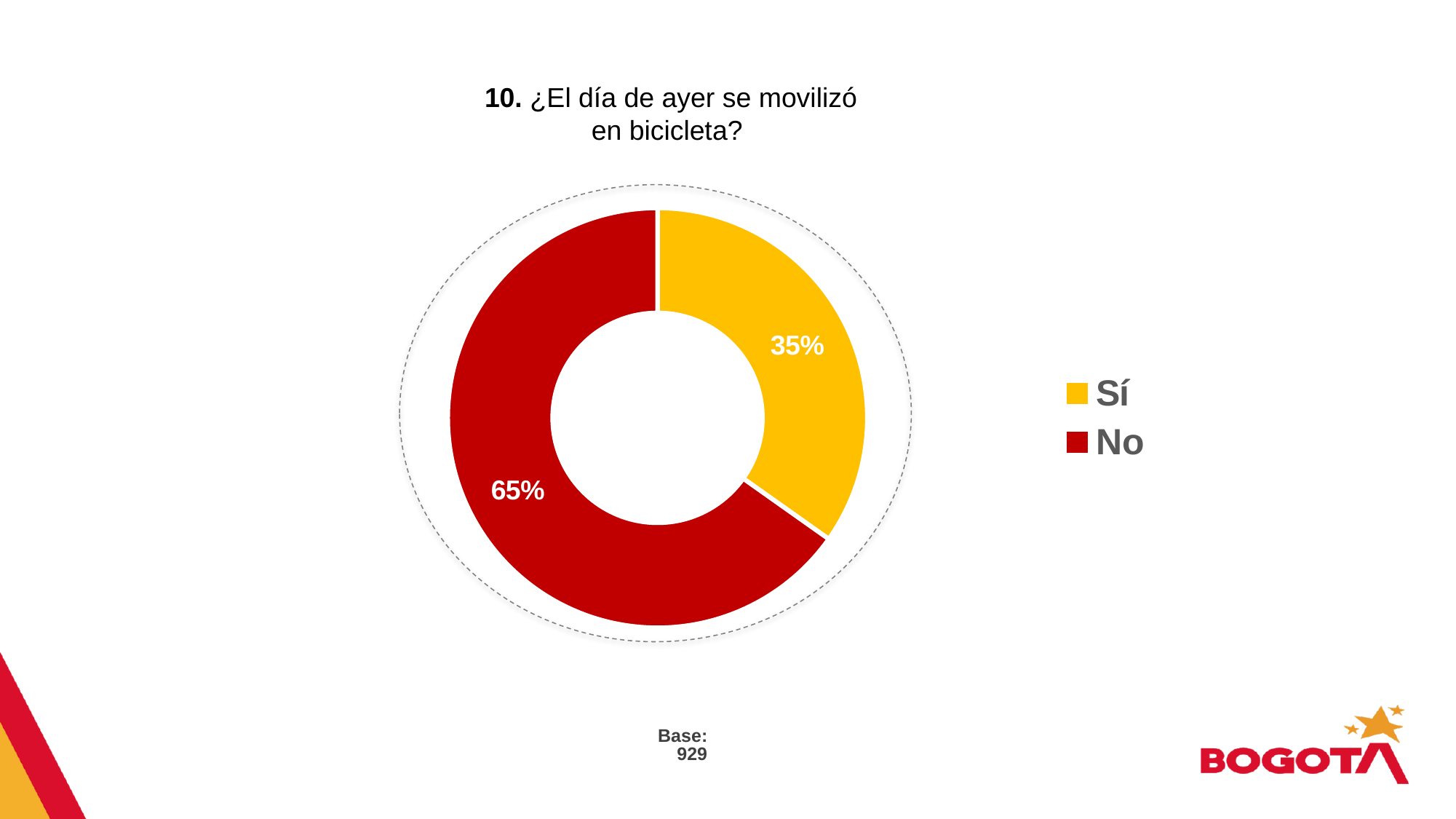
What kind of chart is shown on the slide? Pie chart (doughnut) What share of the pie does the "Sí" slice represent? 35% Which response has the largest share of the chart? No What percentage of respondents answered "Sí"? 35% What is the base (number of respondents) shown below the chart? 929 Which is larger, the share for "Sí" or the share for "No"? No What colour represents the "No" response in the chart? Red How many entries does the legend list? 2 Which response has the smallest share of the chart? Sí How many categories does the chart show? 2 What percentage of respondents answered "No"? 65% What is the difference in percentage points between the "No" and "Sí" shares? 30